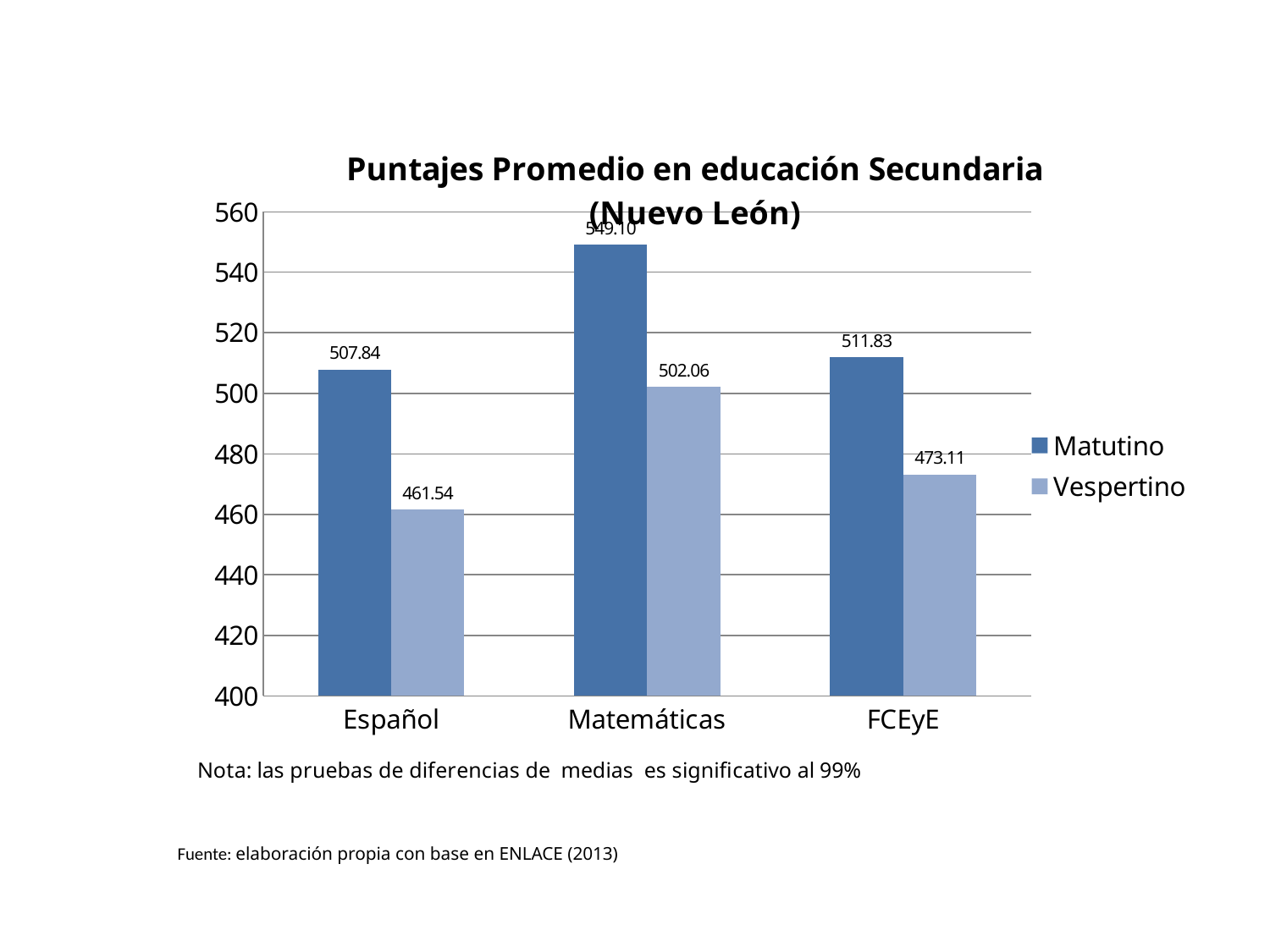
How many subject categories are shown on the x axis? 3 What kind of chart is shown on the slide? Bar chart Which subject has the lowest Vespertino score? Español What is the Vespertino value for Español? 461.54 What is the difference between the Matutino and Vespertino scores for Español? 46.30 What is the Vespertino value for FCEyE? 473.11 What is the difference between the Matutino and Vespertino scores for FCEyE? 38.72 How many series does the legend list? 2 What is the Matutino value for Matemáticas? 549.10 Is the Vespertino value for Matemáticas greater or less than 500? greater Which is larger for Matemáticas, the Matutino or the Vespertino score? Matutino Which subject has the highest Matutino score? Matemáticas